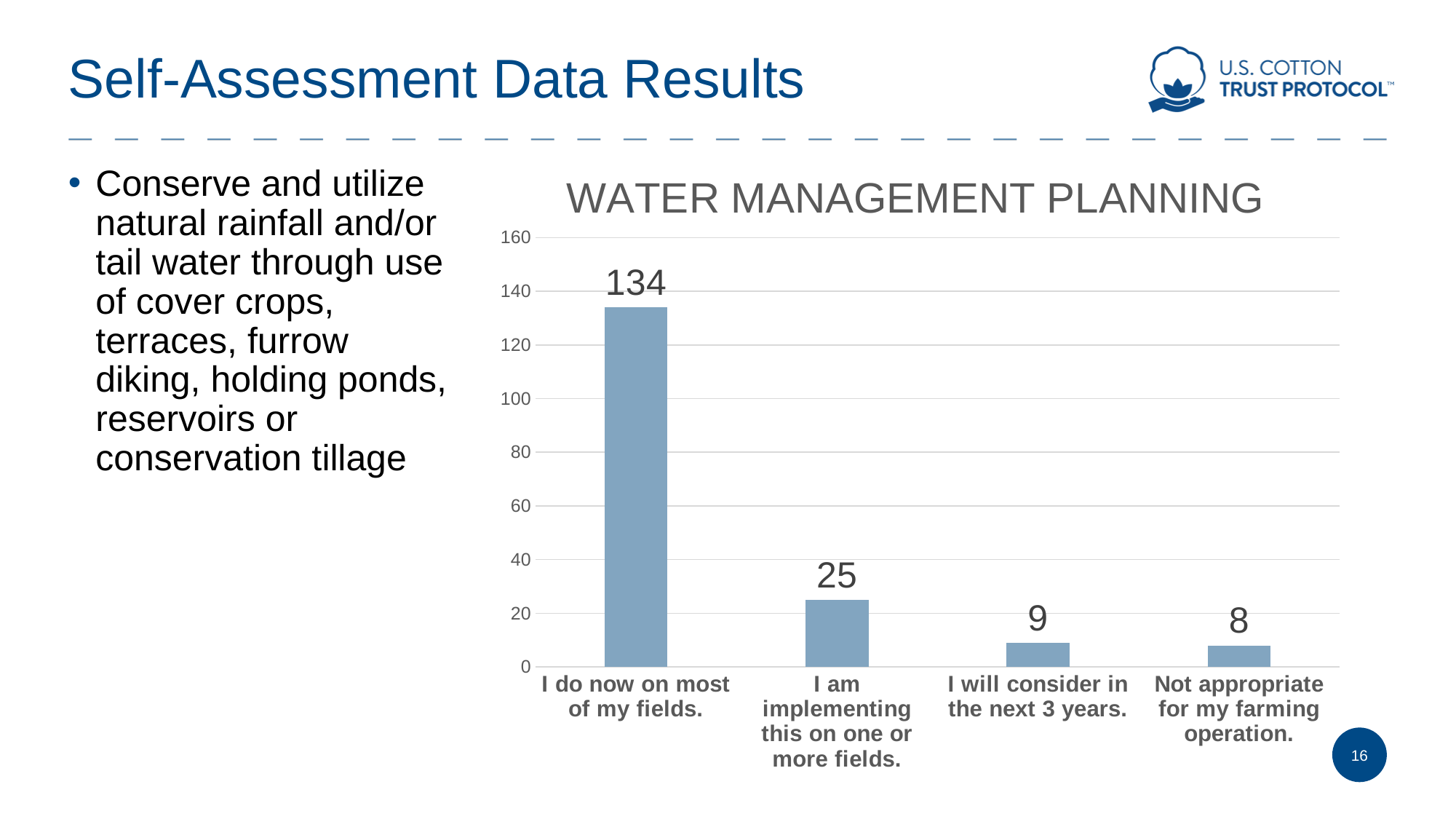
What is the value for "I am implementing this on one or more fields."? 25 What is the value for "Not appropriate for my farming operation."? 8 Which category has the lowest value? Not appropriate for my farming operation. What is the title of the chart? WATER MANAGEMENT PLANNING What is the value for "I do now on most of my fields."? 134 Is the value for "I do now on most of my fields." greater or less than 120? greater Which is larger: the value for "I am implementing this on one or more fields." or the value for "I will consider in the next 3 years."? I am implementing this on one or more fields. What kind of chart is shown on the slide? bar chart How many categories are shown on the chart? 4 What is the difference between the values for "I do now on most of my fields." and "I am implementing this on one or more fields."? 109 What is the value for "I will consider in the next 3 years."? 9 Which category has the highest value? I do now on most of my fields.